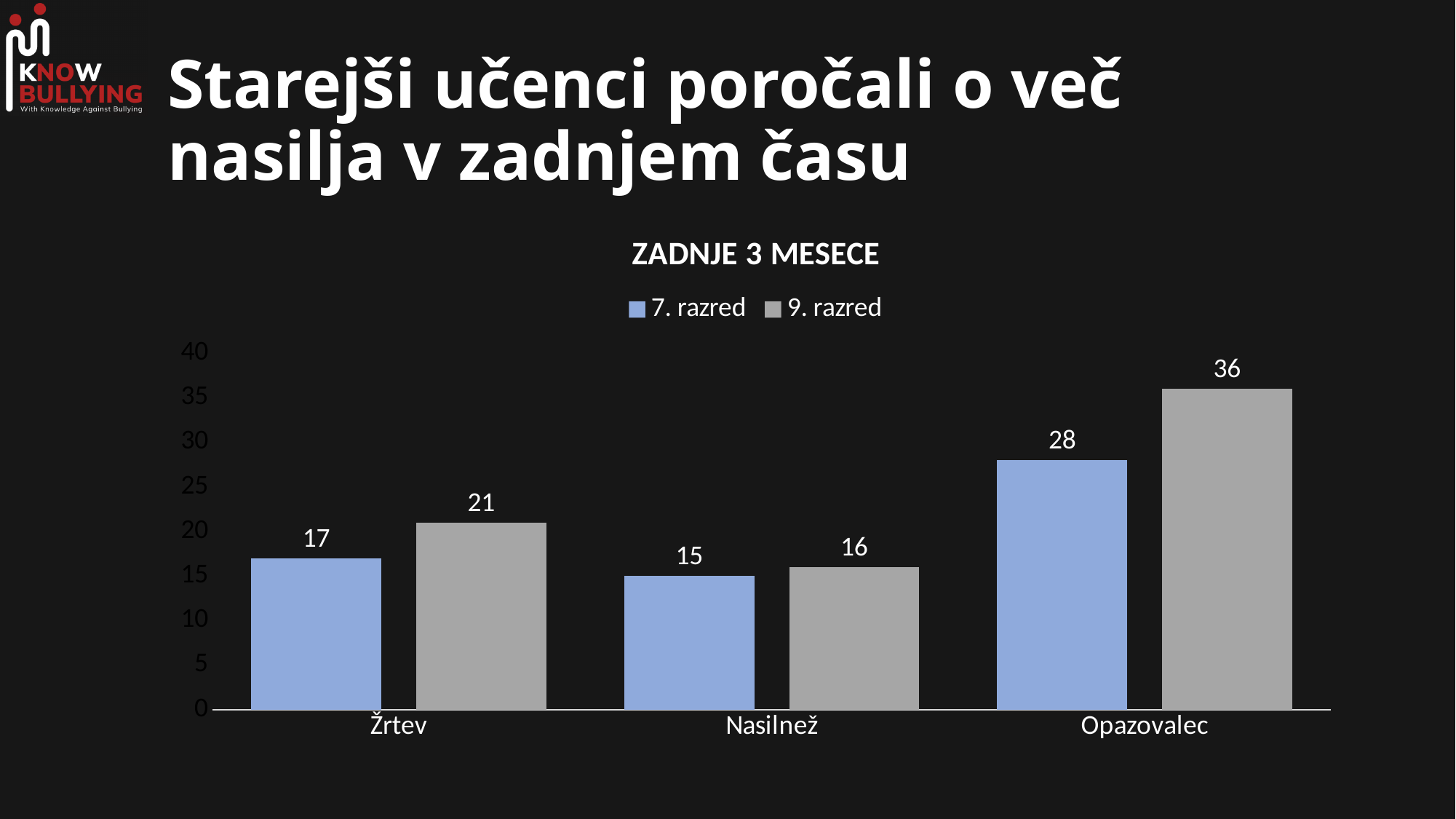
How many series does the legend list? 2 What is the value for 9. razred in the Opazovalec category? 36 What is the difference between the 9. razred and 7. razred values in the Žrtev category? 4 Which category has the highest value for 9. razred? Opazovalec What is the difference between the 9. razred and 7. razred values in the Opazovalec category? 8 Which category has the lowest value for 7. razred? Nasilnež What kind of chart is shown on the slide? Bar chart How many categories are shown on the x axis? 3 Which is larger in the Žrtev category: the 7. razred value or the 9. razred value? 9. razred What is the value for 7. razred in the Žrtev category? 17 What is the value for 9. razred in the Nasilnež category? 16 What is the title of the chart? ZADNJE 3 MESECE